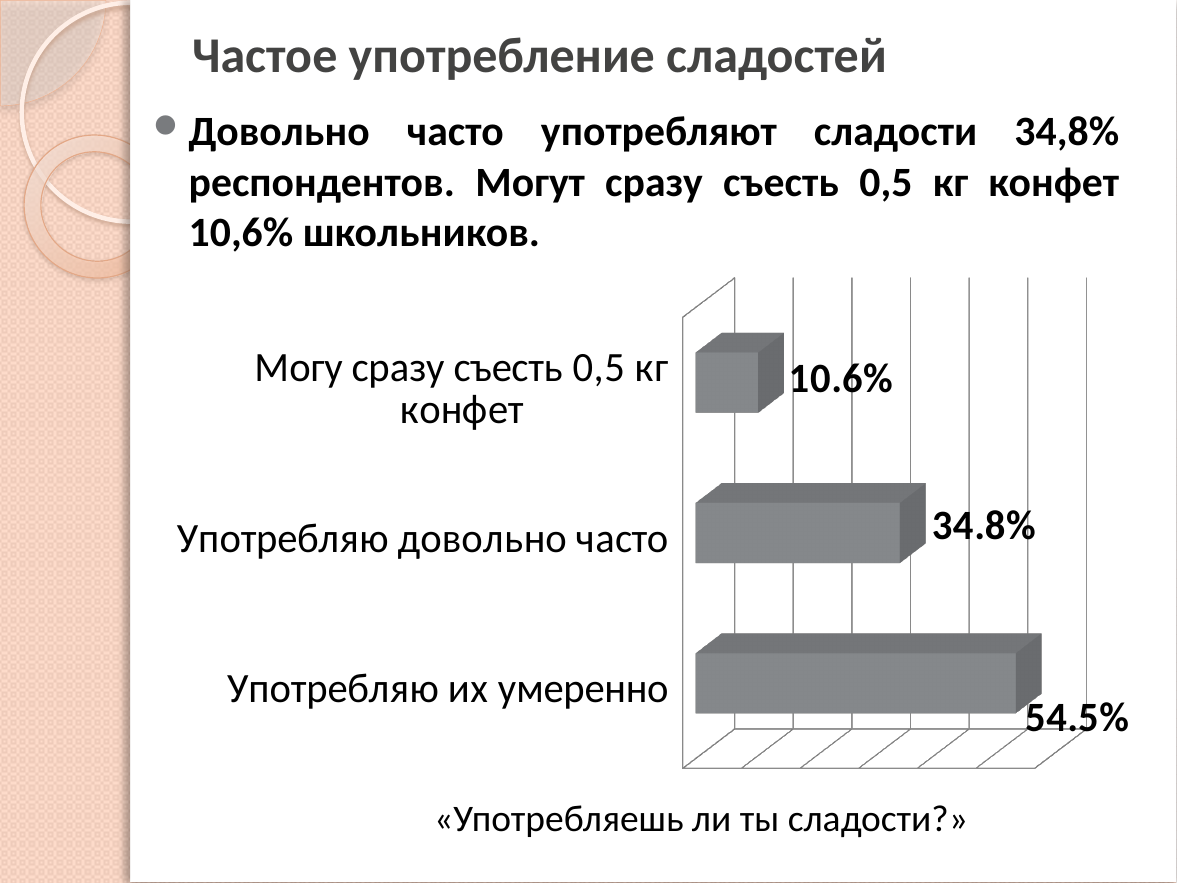
Which is larger: «Употребляю довольно часто» or «Могу сразу съесть 0,5 кг конфет»? Употребляю довольно часто Which category has the lowest value? Могу сразу съесть 0,5 кг конфет What is the difference between «Употребляю их умеренно» and «Употребляю довольно часто»? 19.7% What is the value for «Могу сразу съесть 0,5 кг конфет»? 10.6% What is the value for «Употребляю их умеренно»? 54.5% Which category has the highest value? Употребляю их умеренно What is the value for «Употребляю довольно часто»? 34.8% How many categories are shown in the chart? 3 What is the difference between «Употребляю довольно часто» and «Могу сразу съесть 0,5 кг конфет»? 24.2% What is the title of the chart? «Употребляешь ли ты сладости?» What colour are the bars in the chart? Grey What kind of chart is shown on the slide? Bar chart